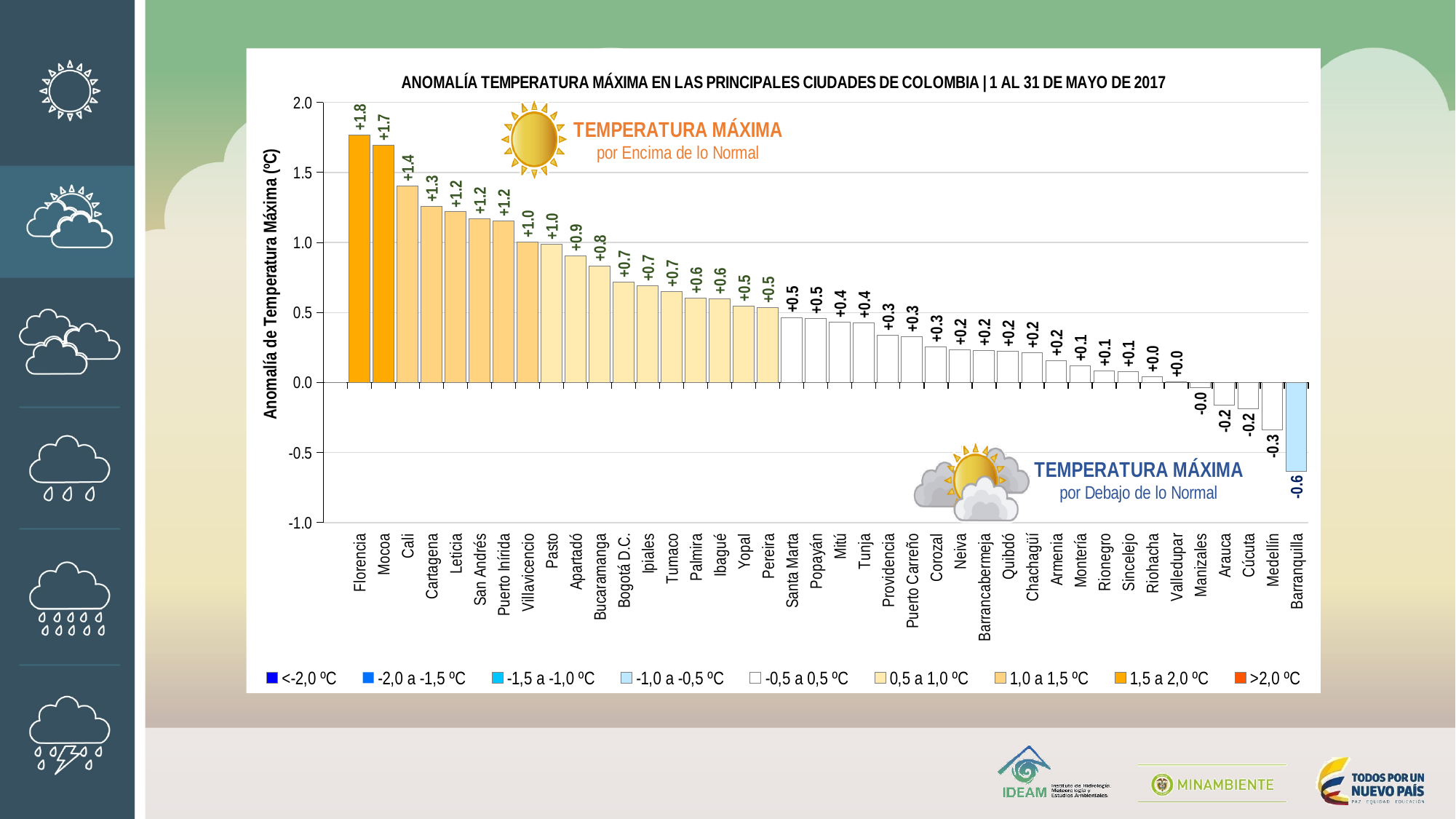
How many cities are shown on the chart? 40 Is the value for Medellín greater or less than 0.0? less Which city has the highest maximum temperature anomaly? Florencia What is the value shown for Bogotá D.C.? +0.7 Which city has the lowest maximum temperature anomaly? Barranquilla What is the maximum temperature anomaly shown for Florencia? +1.8 Which has a larger anomaly, Mocoa or Cartagena? Mocoa What kind of chart is this? bar chart Do the values rise or fall from left to right along the x axis? fall How many range entries does the legend list? 9 What is the value shown for Barranquilla? -0.6 What is the difference between the values for Florencia and Cali? 0.4